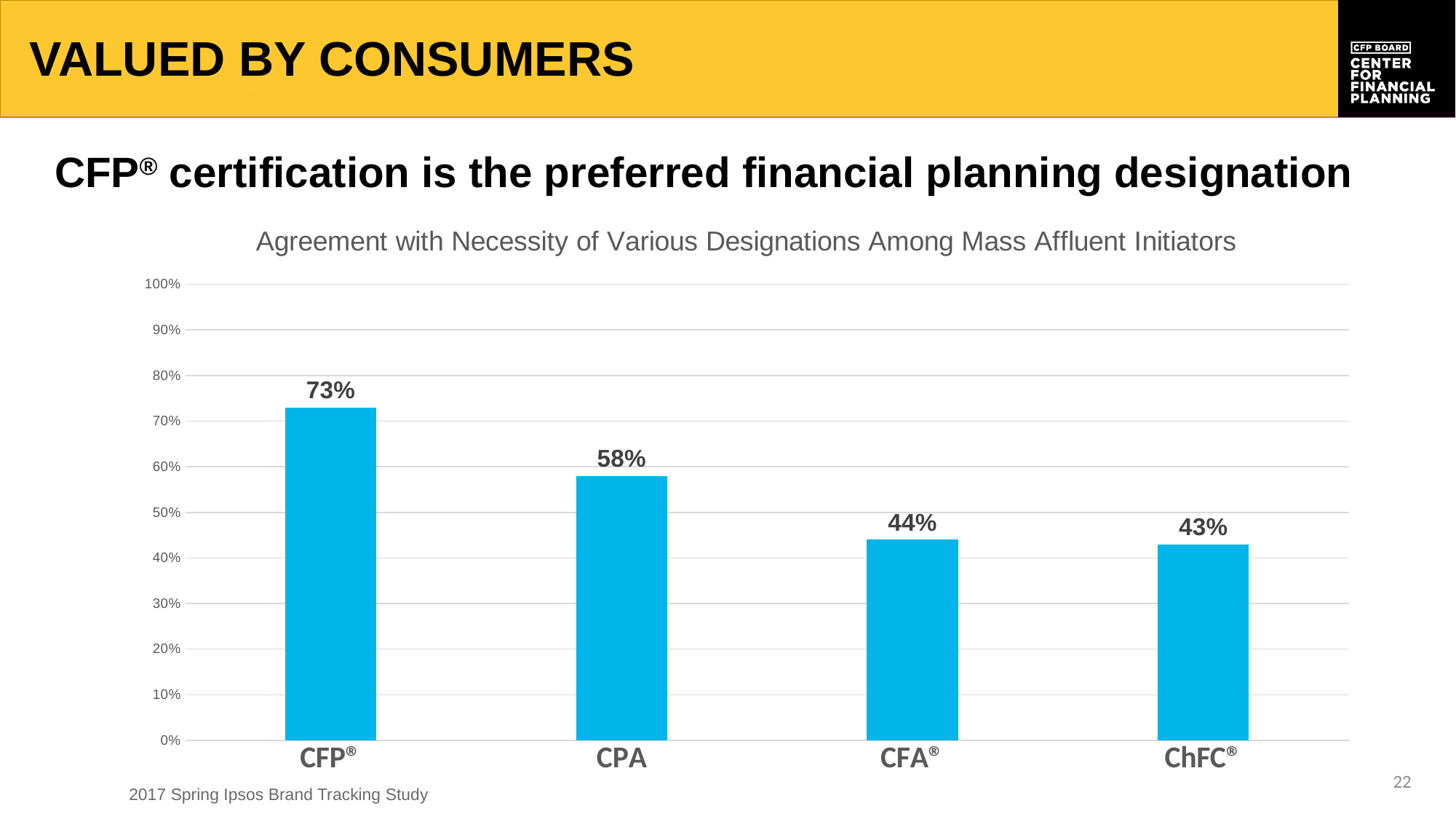
What is the title of the chart? Agreement with Necessity of Various Designations Among Mass Affluent Initiators How many designations are shown in the chart? 4 What is the difference between the values for CPA and CFA®? 14% What is the difference between the values for CFP® and CPA? 15% Which is larger, the value for CPA or the value for CFA®? CPA What is the value for CFA® in the chart? 44% What is the value for CFP® in the chart? 73% What kind of chart is shown on the slide? Bar chart Which designation has the lowest agreement value? ChFC® What is the value for CPA in the chart? 58% What is the value for ChFC® in the chart? 43% Which designation has the highest agreement value? CFP®